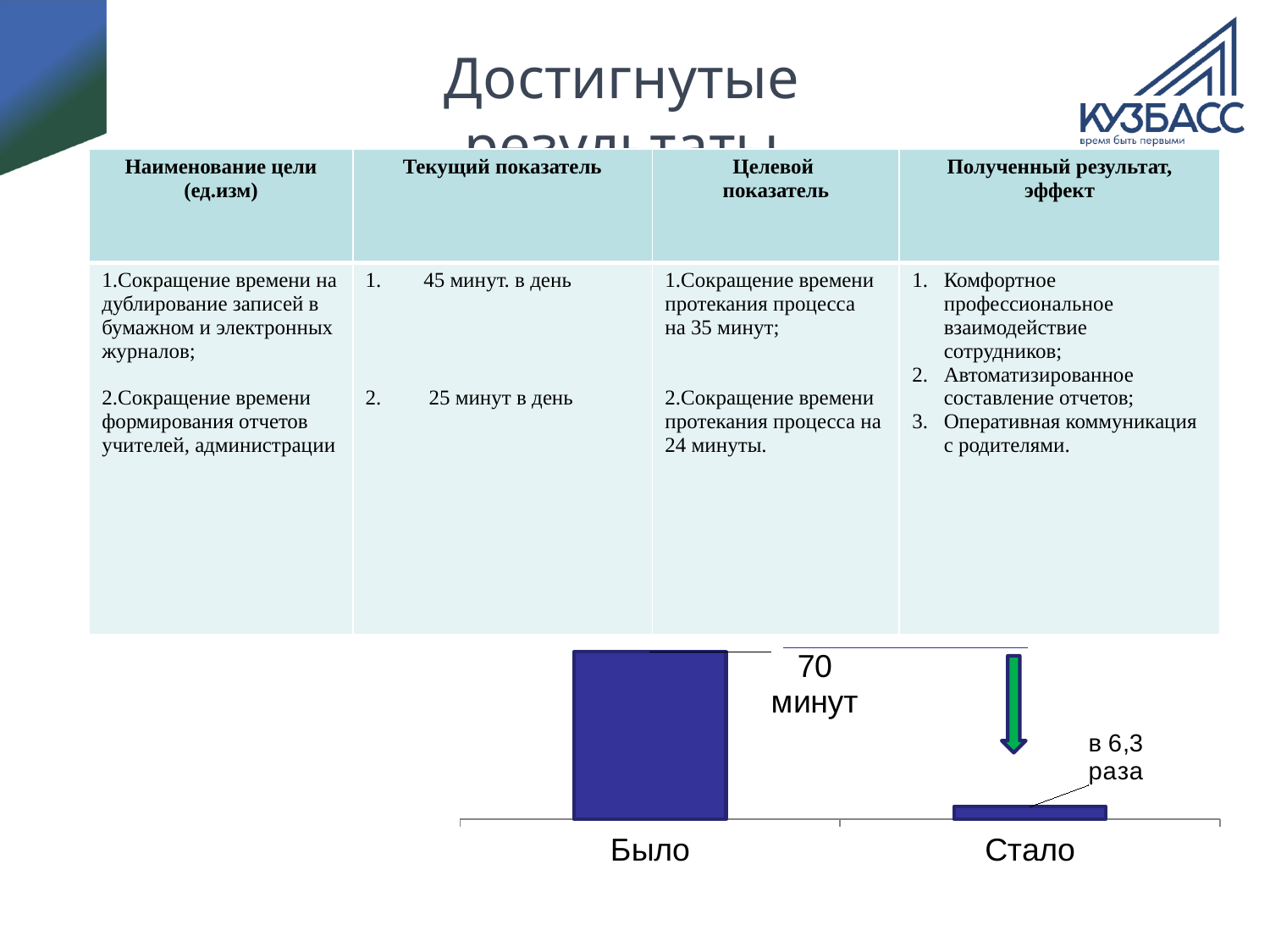
What annotation is attached to the Стало bar in the chart? в 6,3 раза What kind of chart is shown at the bottom of the slide? bar chart Which category in the bar chart has the lowest bar? Стало Do the bar values rise or fall from Было to Стало? fall What are the two category labels on the x axis of the bar chart? Было, Стало How many categories does the bar chart at the bottom of the slide show? 2 Which category in the bar chart has the highest bar? Было Which bar is taller in the chart, Было or Стало? Было What value is labelled on the Было bar in the chart? 70 минут